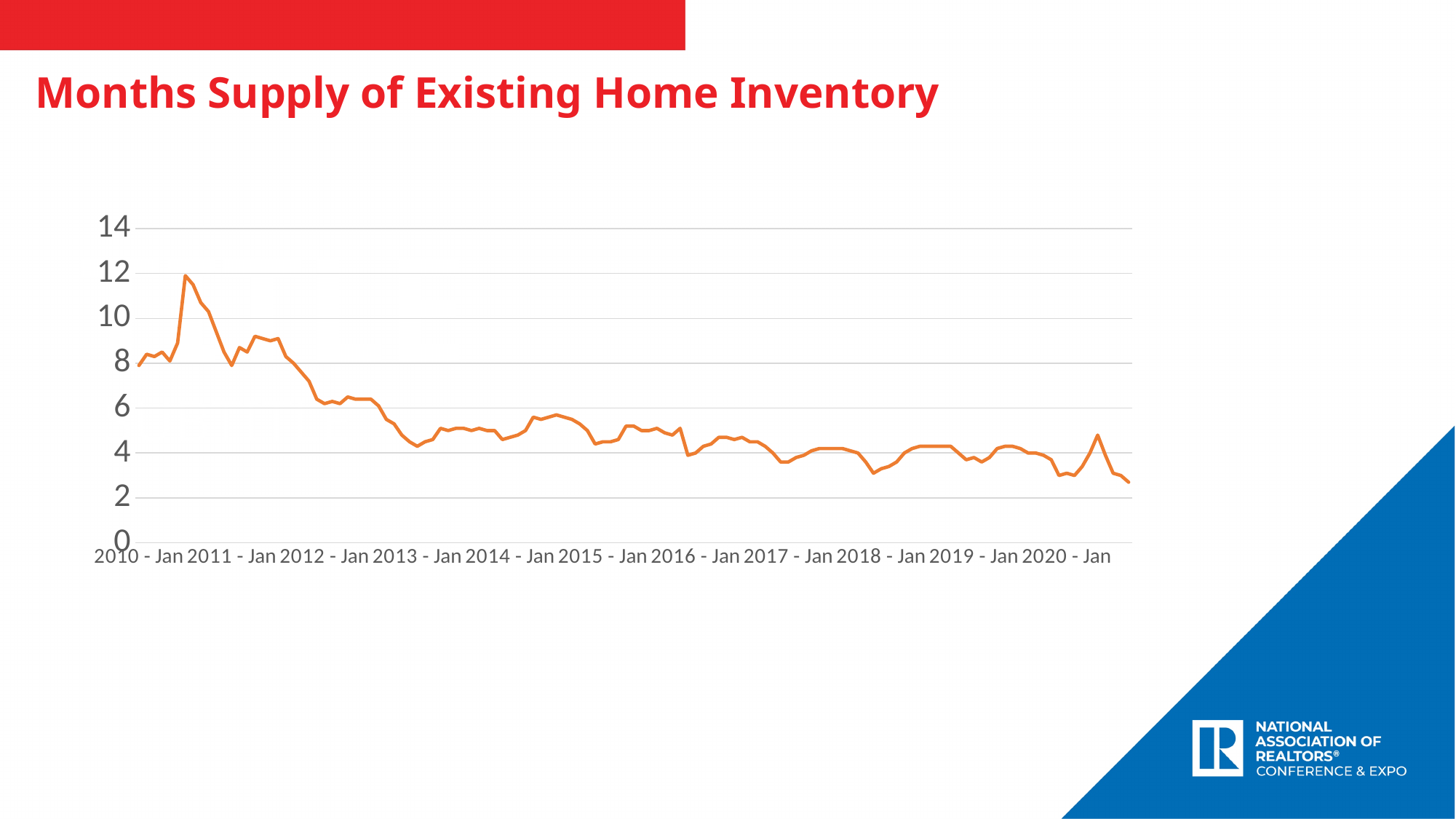
Which is higher, the value at 2010 - Jan or the value at 2020 - Jan? 2010 - Jan What is the highest value shown on the y axis? 14 What kind of chart is shown on the slide? line chart Is the value at 2020 - Jan greater or less than 4? less Which is higher, the value at 2012 - Jan or the value at 2013 - Jan? 2012 - Jan What is the title of the chart? Months Supply of Existing Home Inventory How many year labels are shown on the x axis? 11 Is the value at 2015 - Jan greater or less than 6? less Is the value at 2011 - Jan greater or less than 6? greater Overall, do the values rise or fall from 2010 - Jan to 2020 - Jan? fall